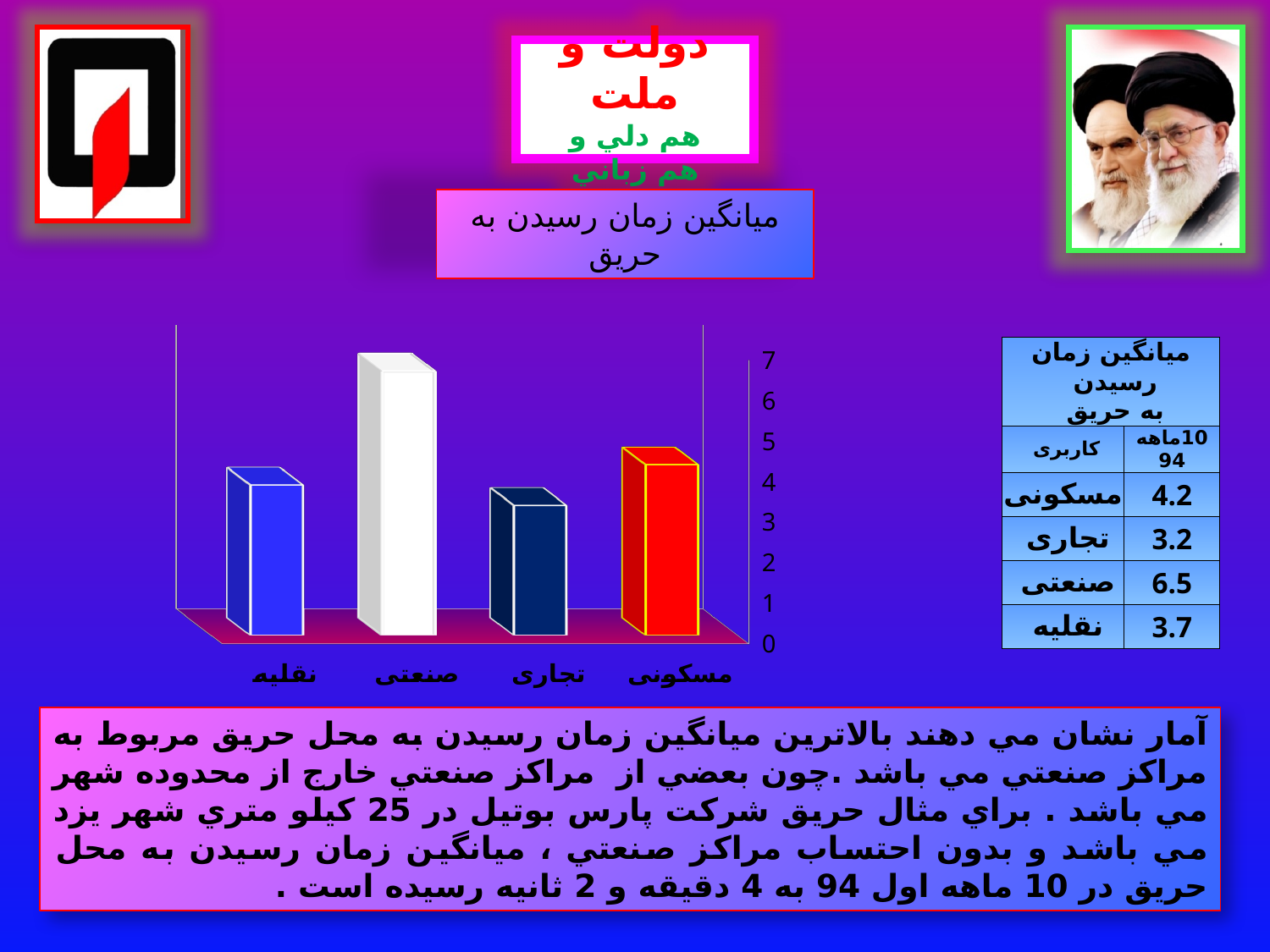
Which category has the lowest bar in the chart? تجاری How many categories are plotted in the bar chart? 4 What is the difference between the values for صنعتی and تجاری? 3.3 What is the title shown above the chart? میانگین زمان رسیدن به حریق What is the value for مسکونی? 4.2 Is the value for صنعتی greater or less than 6? greater What kind of chart is shown on the slide? bar chart What is the value for نقلیه? 3.7 Which category has the highest bar in the chart? صنعتی Which is larger, the value for صنعتی or the value for مسکونی? صنعتی What is the value for صنعتی? 6.5 Is the value for تجاری greater or less than 4? less